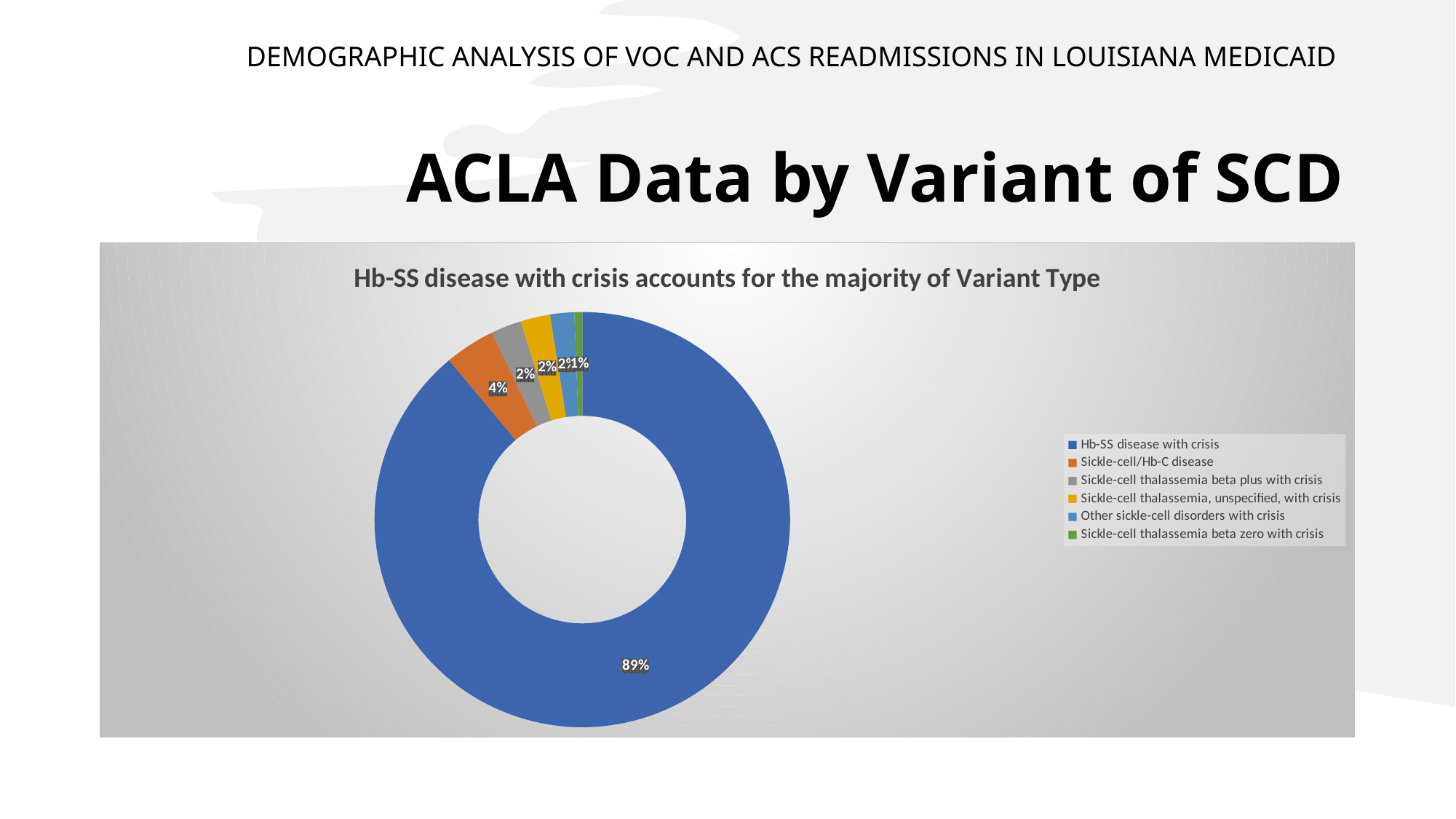
What is the chart's title? Hb-SS disease with crisis accounts for the majority of Variant Type What share of the chart does Hb-SS disease with crisis account for? 89% What share of the chart does Sickle-cell thalassemia beta zero with crisis account for? 1% What share of the chart does Sickle-cell thalassemia beta plus with crisis account for? 2% Which variant has the smallest share of the chart? Sickle-cell thalassemia beta zero with crisis What is the difference in percentage points between Hb-SS disease with crisis and Sickle-cell/Hb-C disease? 85 How many variant categories does the chart show? 6 What colour is the slice for Sickle-cell/Hb-C disease? orange What kind of chart is shown on the slide? doughnut chart Which is larger, the share for Sickle-cell/Hb-C disease or the share for Sickle-cell thalassemia beta zero with crisis? Sickle-cell/Hb-C disease What share of the chart does Sickle-cell/Hb-C disease account for? 4% Which variant has the largest share of the chart? Hb-SS disease with crisis